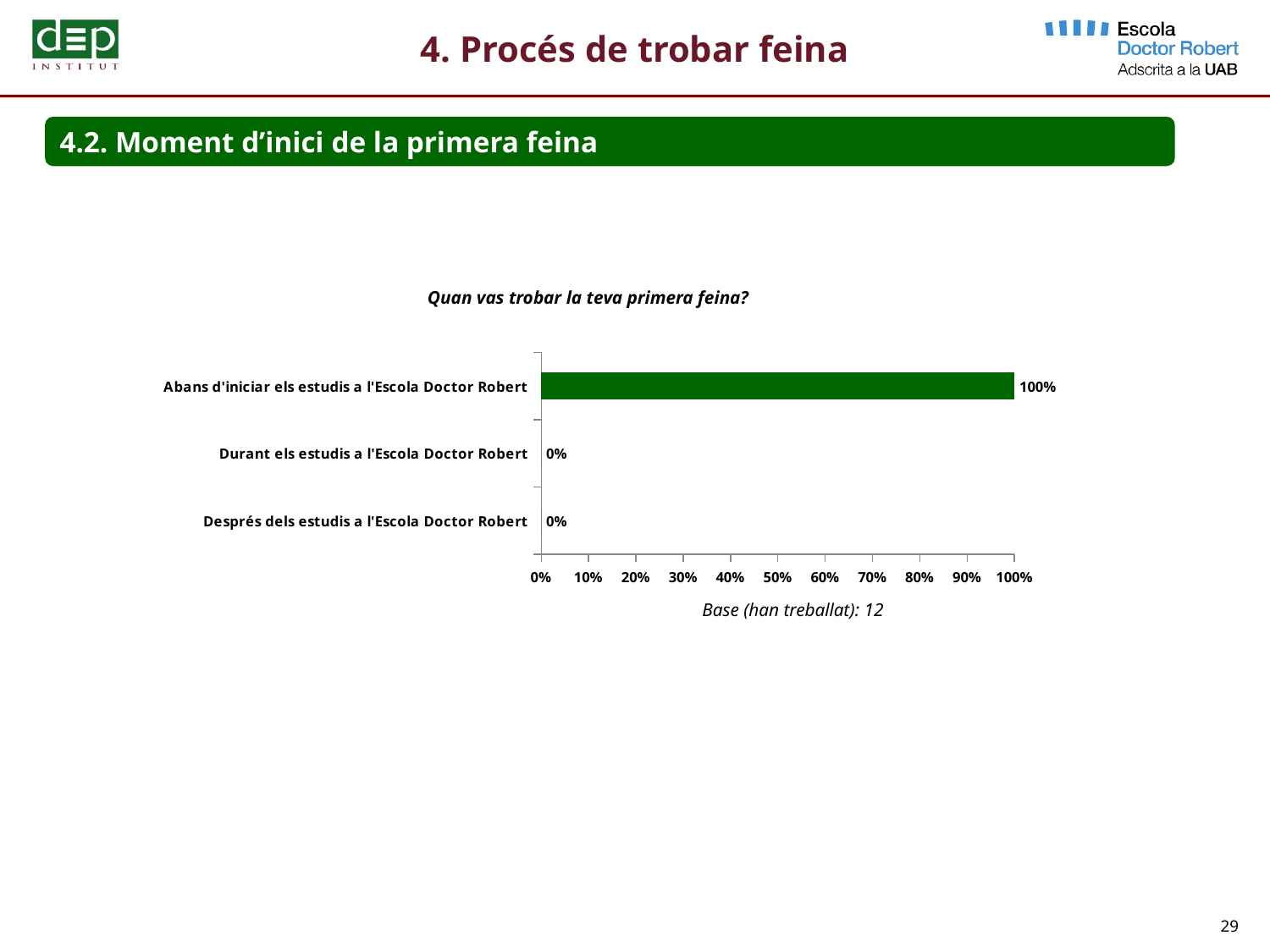
Which category has the highest value? Abans d'iniciar els estudis a l'Escola Doctor Robert What is the base (number of respondents) stated below the chart? 12 What is the difference between the values for "Abans d'iniciar els estudis a l'Escola Doctor Robert" and "Durant els estudis a l'Escola Doctor Robert"? 100% What is the question shown as the chart's title? Quan vas trobar la teva primera feina? What kind of chart is shown on the slide? bar chart What is the value for "Durant els estudis a l'Escola Doctor Robert"? 0% What is the highest value shown on the x axis? 100% What is the value for "Abans d'iniciar els estudis a l'Escola Doctor Robert"? 100% Which is larger, the value for "Abans d'iniciar els estudis a l'Escola Doctor Robert" or the value for "Després dels estudis a l'Escola Doctor Robert"? Abans d'iniciar els estudis a l'Escola Doctor Robert Is the value for "Abans d'iniciar els estudis a l'Escola Doctor Robert" greater or less than 50%? greater What is the value for "Després dels estudis a l'Escola Doctor Robert"? 0% How many categories are shown in the chart? 3